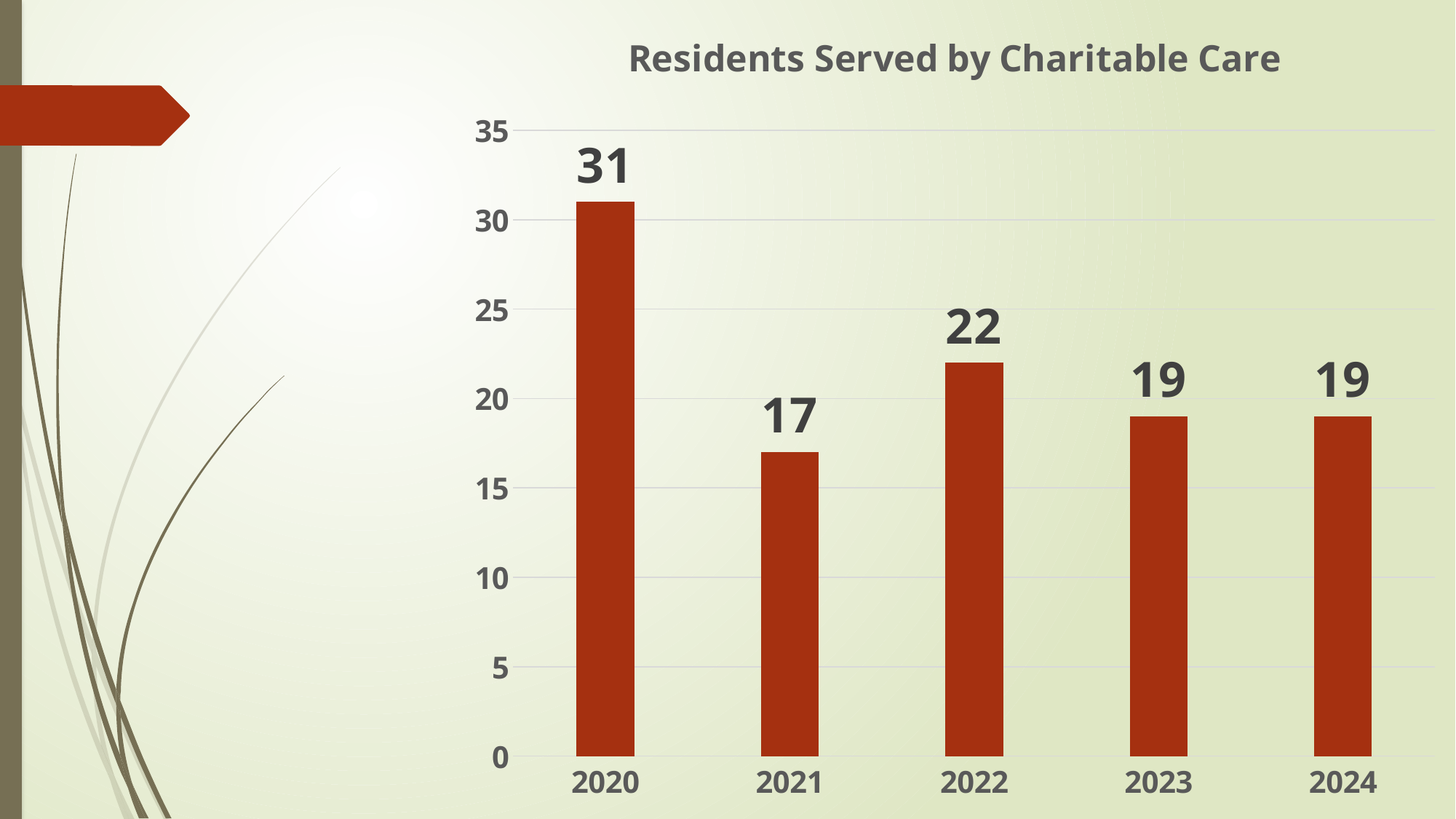
Which year has the highest number of residents served? 2020 What is the difference between the values for 2022 and 2023? 3 Which is larger, the value for 2021 or the value for 2022? 2022 What is the value for 2022? 22 What is the value for 2021? 17 How many years are shown on the x axis? 5 What is the title of the chart? Residents Served by Charitable Care Which year has the lowest number of residents served? 2021 What is the value for 2024? 19 What is the value for 2020? 31 What kind of chart is this? bar chart What is the difference between the values for 2020 and 2021? 14